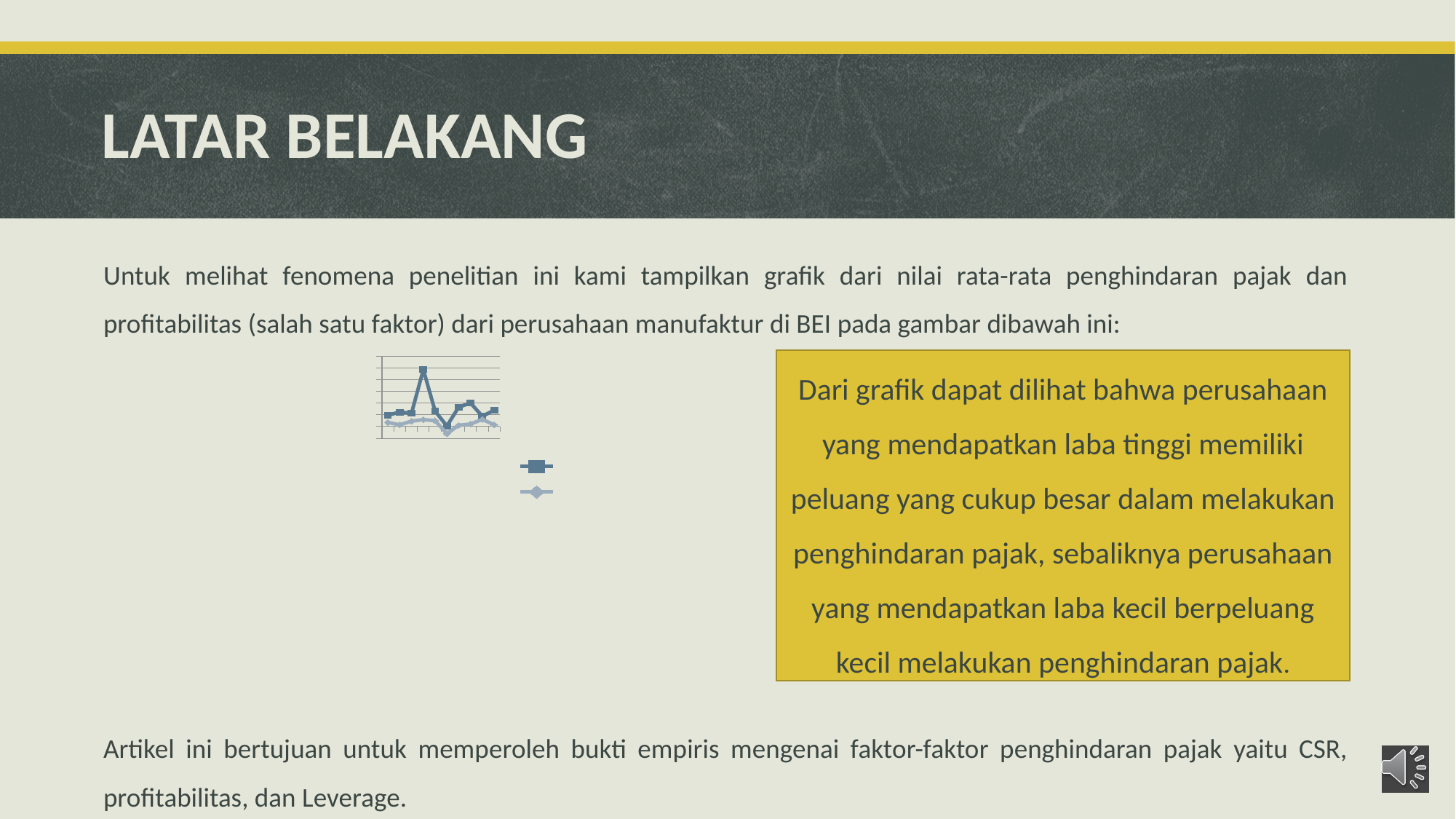
How many series does the chart's legend list? 2 Which line on the chart reaches the highest peak, the darker line or the lighter line? the darker line What kind of chart is shown on the slide? line chart